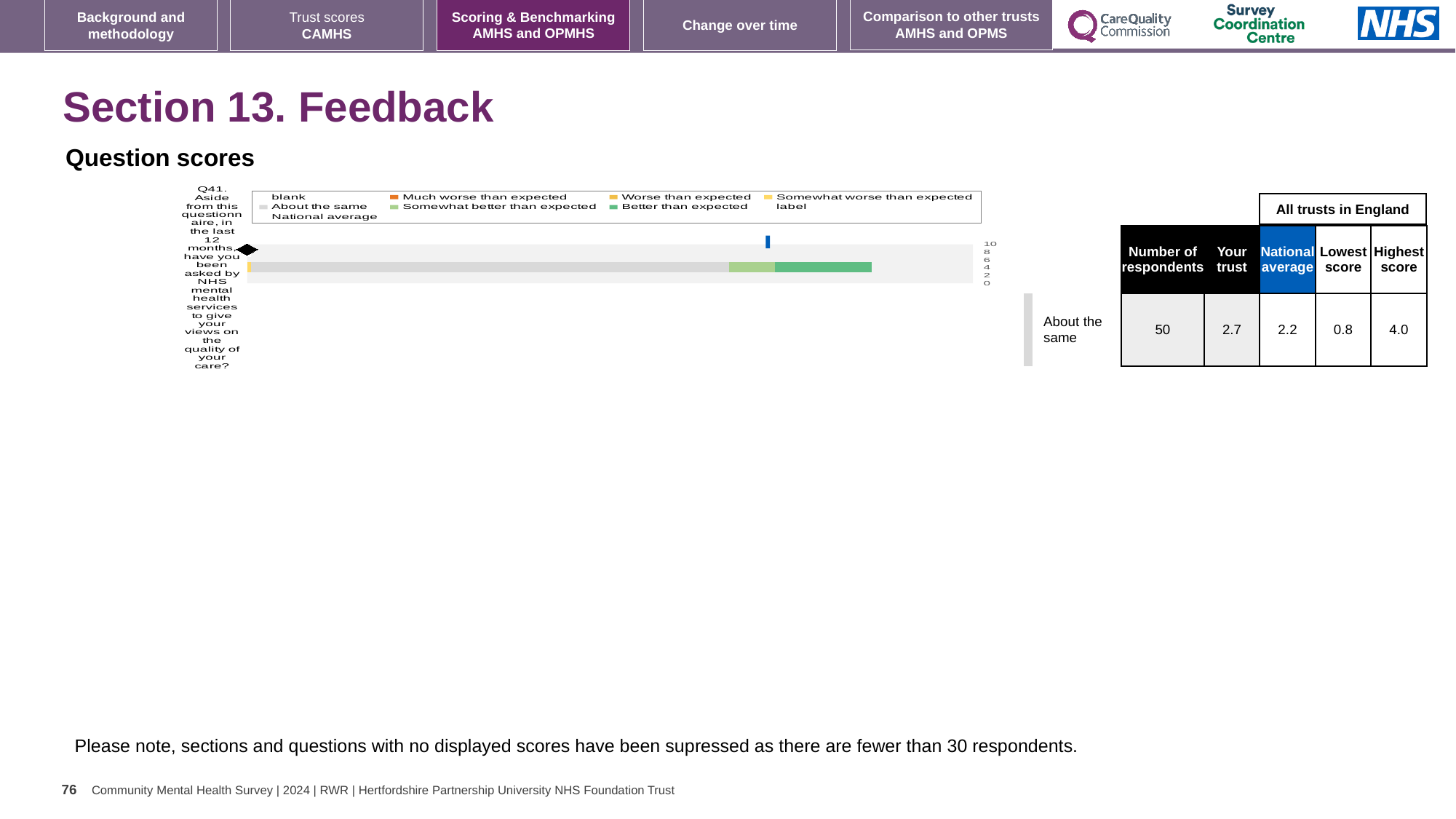
In the table next to the chart, what is the lowest score among all trusts in England for Q41? 0.8 In the table next to the chart, what is the national average score for Q41? 2.2 What kind of chart is shown for Q41? bar chart What is the difference between the 'Your trust' score and the national average for Q41? 0.5 According to the label beside the chart, how does the trust's score for Q41 compare with what is expected? About the same In the table next to the chart, what is the highest score among all trusts in England for Q41? 4.0 Which question number is plotted in the chart? Q41 Is the 'Your trust' score for Q41 higher or lower than the national average? higher In the table next to the chart, what is the 'Your trust' score for Q41? 2.7 In the table next to the chart, what is the number of respondents for Q41? 50 What is the highest value shown on the chart's axis? 10 How many questions (categories) are plotted in the chart? 1